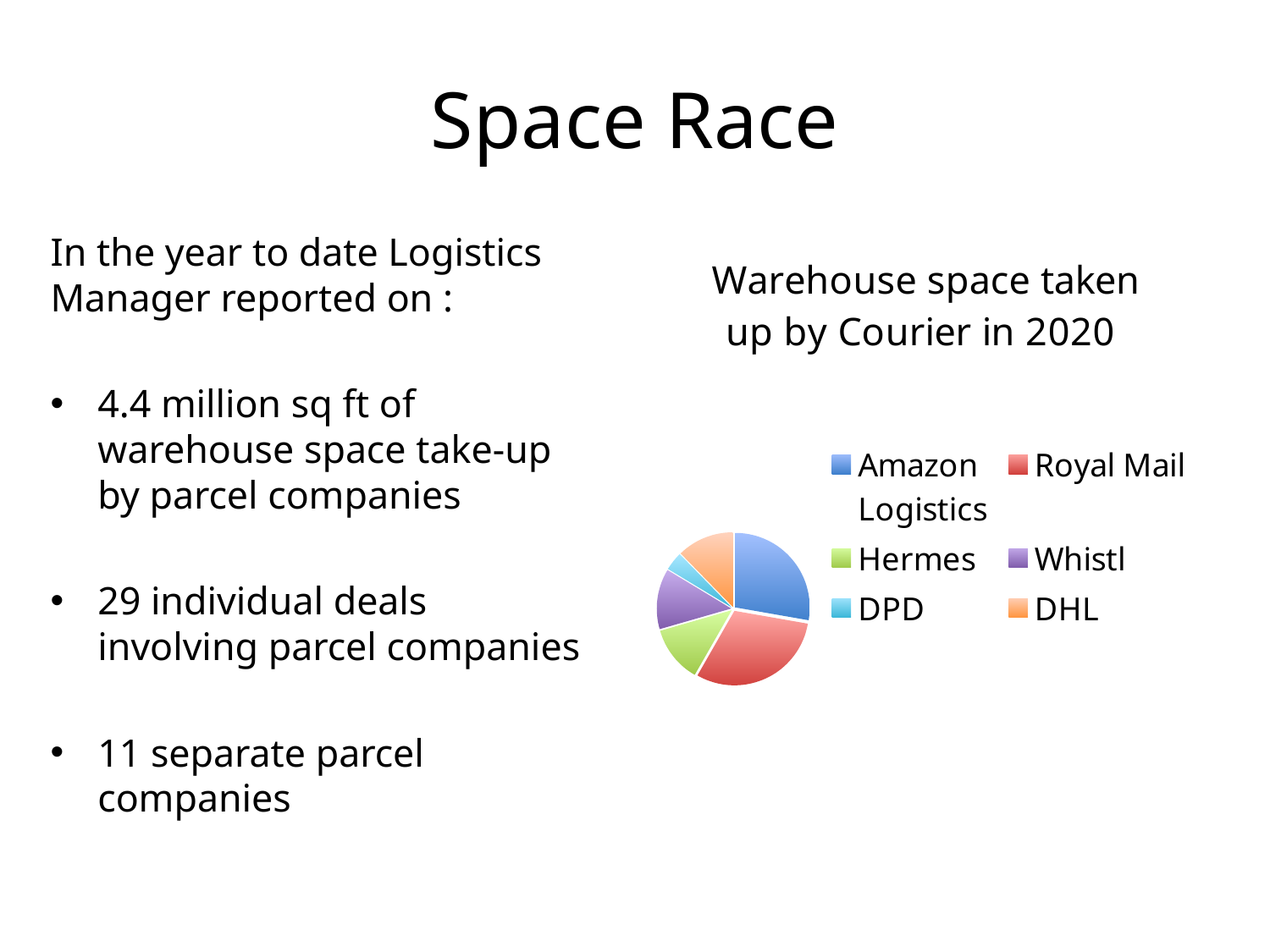
What is the title of the chart? Warehouse space taken up by Courier in 2020 Which slice is larger, Whistl or DPD? Whistl Which slice is larger, Amazon Logistics or Hermes? Amazon Logistics Which courier has the smallest slice of the pie chart? DPD What kind of chart is shown on the slide? pie chart Which colour represents Royal Mail in the pie chart? red Which slice is larger, Royal Mail or Whistl? Royal Mail How many couriers (slices) are shown in the pie chart? 6